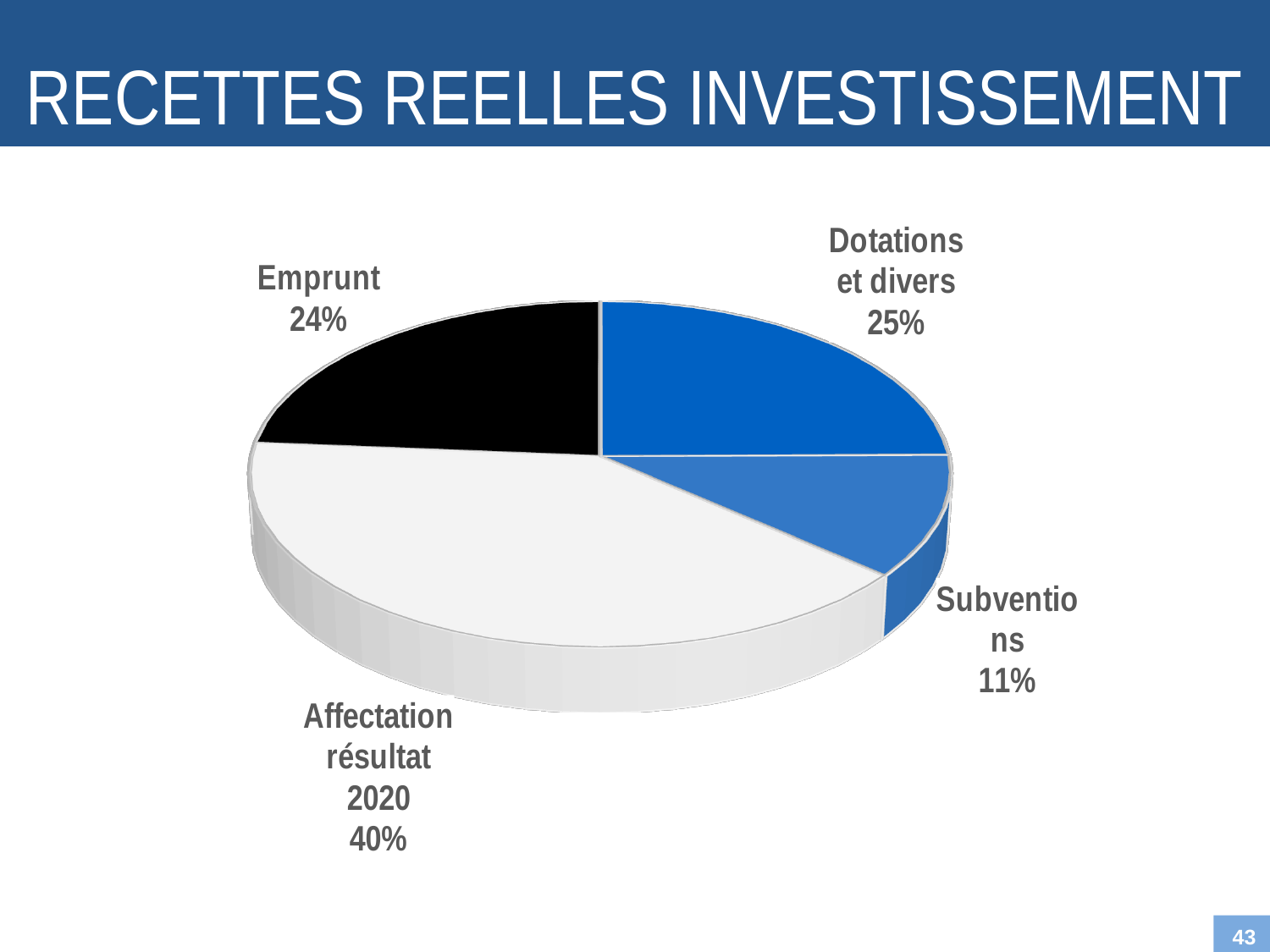
What share of the pie does Emprunt represent? 24% What share of the pie does Dotations et divers represent? 25% Which category has the smallest slice of the pie? Subventions Which category has the largest slice of the pie? Affectation résultat 2020 What share of the pie does Affectation résultat 2020 represent? 40% What is the title of the slide containing the chart? RECETTES REELLES INVESTISSEMENT What is the difference in percentage points between Dotations et divers and Subventions? 14 How many categories are shown in the pie chart? 4 What is the difference in percentage points between Affectation résultat 2020 and Emprunt? 16 Which is larger, the share for Emprunt or the share for Subventions? Emprunt What kind of chart is shown on the slide? Pie chart